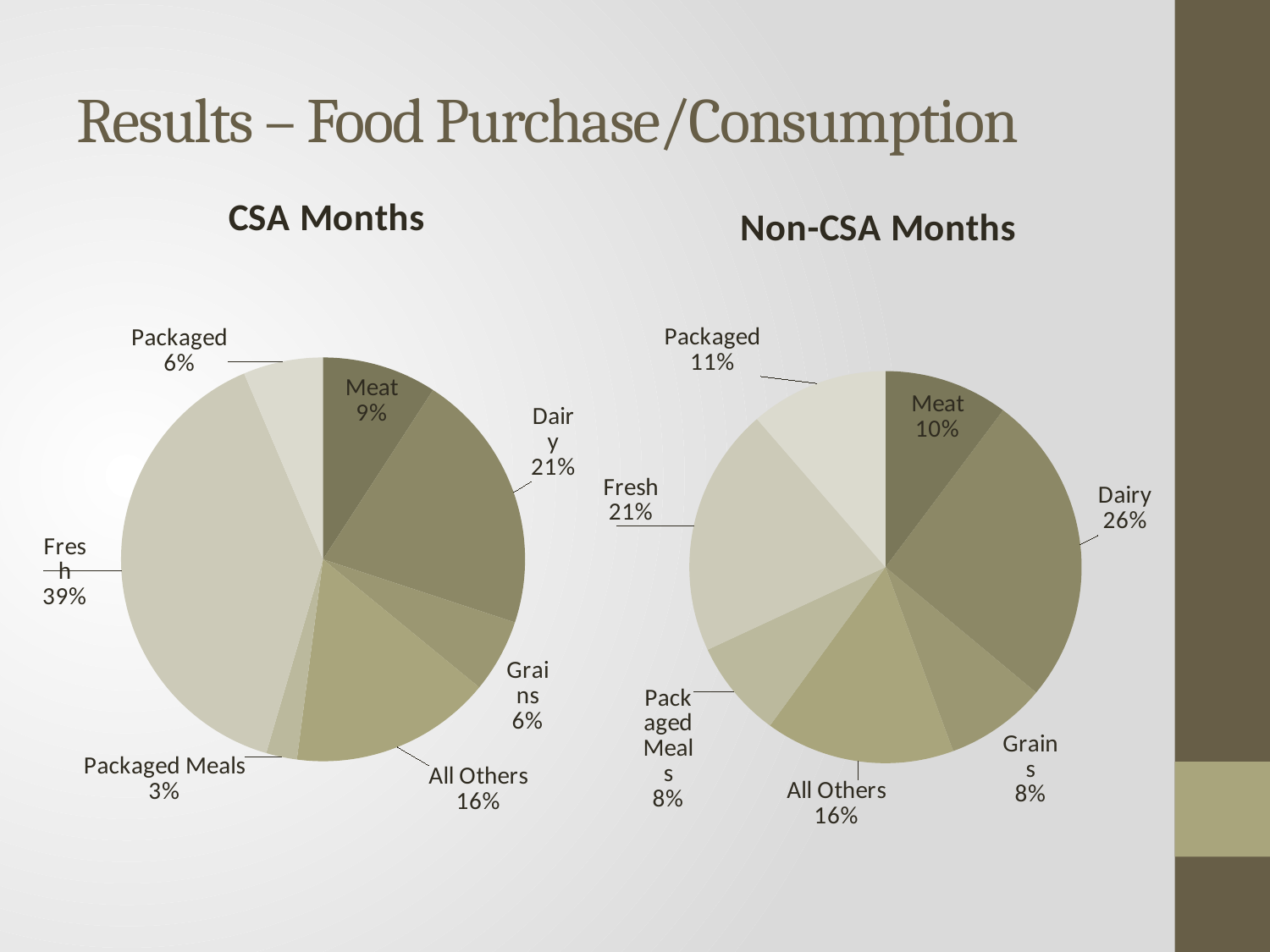
In the CSA Months pie chart, what is the difference between the Fresh share and the Dairy share? 18% In the CSA Months pie chart, which category has the smallest share? Packaged Meals How many categories are shown in the CSA Months pie chart? 7 In the Non-CSA Months pie chart, what share does Dairy have? 26% In the Non-CSA Months pie chart, what share does All Others have? 16% In the Non-CSA Months pie chart, what is the difference between the Dairy share and the Fresh share? 5% What is the title of the chart on the left side of the slide? CSA Months In the CSA Months pie chart, which category has the largest share? Fresh What kind of chart is used for Non-CSA Months? Pie chart In the CSA Months pie chart, what share does Fresh have? 39% In the Non-CSA Months pie chart, which category has the largest share? Dairy In the Non-CSA Months pie chart, which is larger, Packaged or Meat? Packaged